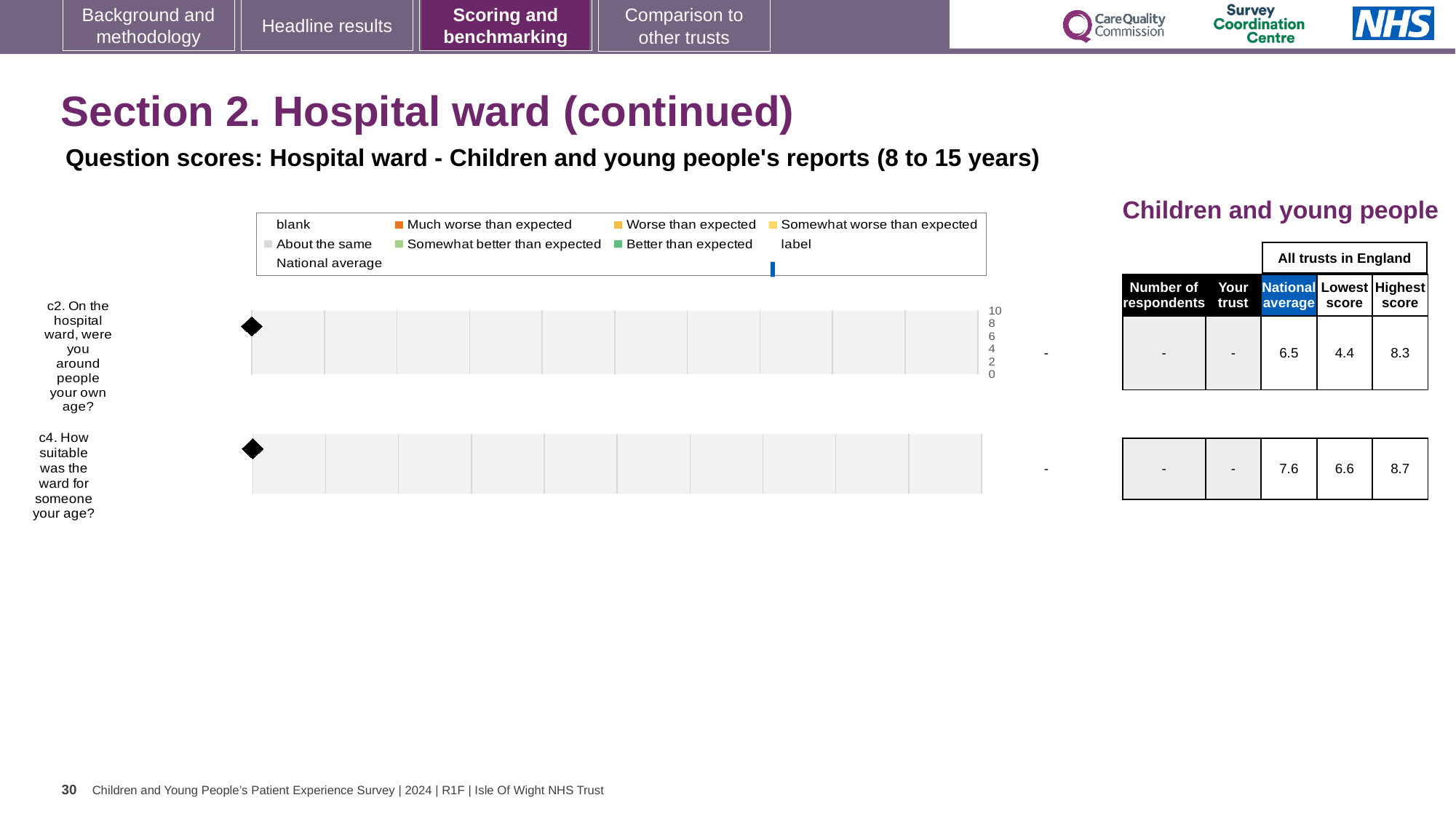
In the legend, what colour is the marker for 'Much worse than expected'? orange In the table to the right of the chart, what is the national average score for question c4? 7.6 How many questions (categories) are plotted in the chart? 2 In the table to the right of the chart, what is the lowest score across all trusts in England for question c2? 4.4 What is the highest value shown on the chart's axis? 10 What data label is printed at the end of the bar for question c2 (On the hospital ward, were you around people your own age?)? - In the table to the right of the chart, what is the highest score across all trusts in England for question c4? 8.7 In the table to the right of the chart, what is the national average score for question c2? 6.5 In the table to the right of the chart, what is the difference between the highest and lowest scores for question c2? 3.9 In the table to the right of the chart, which question has the higher national average, c2 or c4? c4 What data label is printed at the end of the bar for question c4 (How suitable was the ward for someone your age?)? - What kind of chart is used to show the question scores on this slide? bar chart